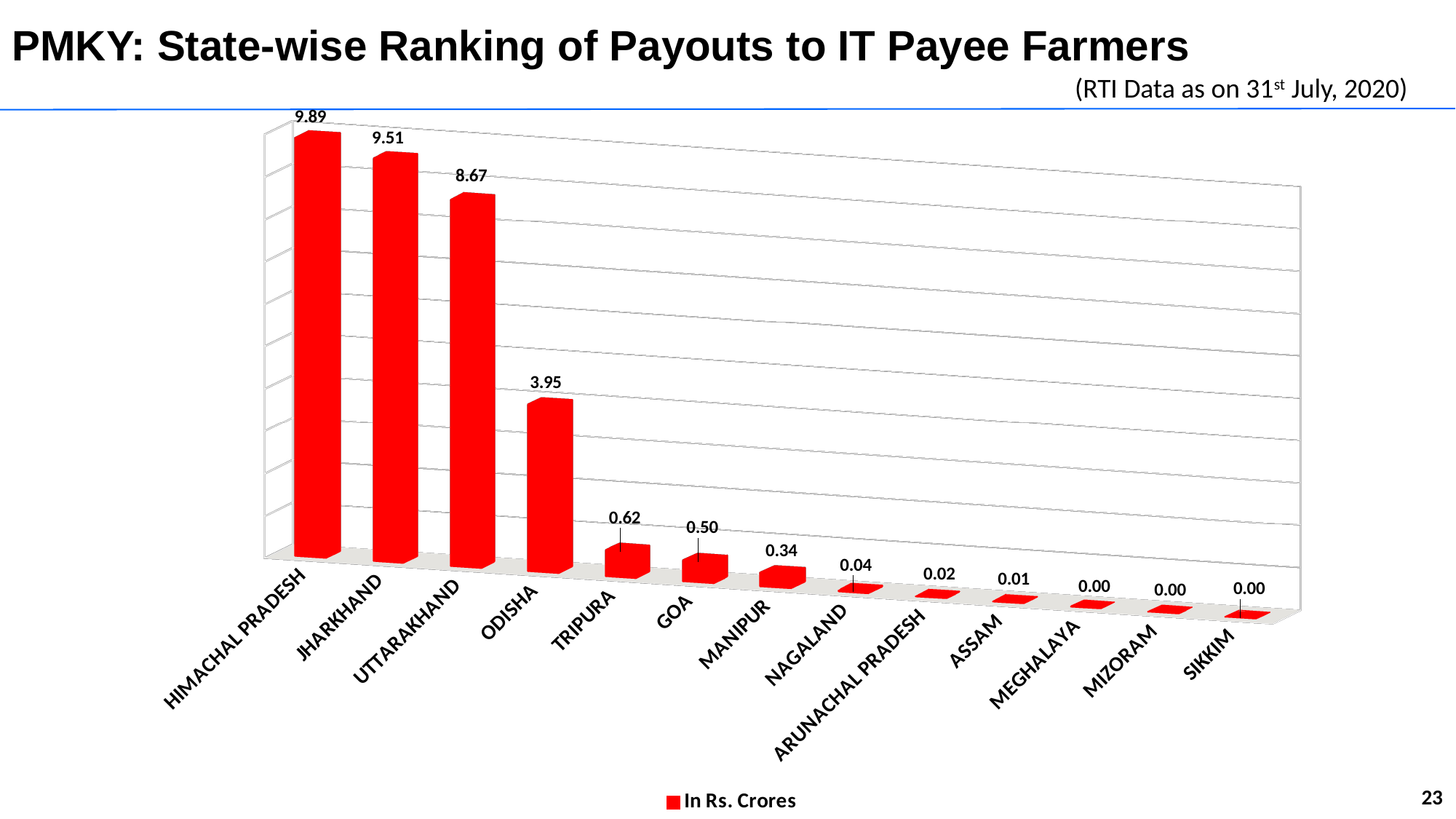
Which is larger, the value for Tripura or the value for Goa? Tripura How many series does the legend list? 1 What is the legend entry for the series? In Rs. Crores What is the value for Odisha? 3.95 What kind of chart is shown? Bar chart Do the values rise or fall from left to right along the x axis? Fall Which state has the highest value? Himachal Pradesh What is the value for Nagaland? 0.04 What is the difference between the values for Jharkhand and Uttarakhand? 0.84 How many states are shown on the chart? 13 What is the value for Himachal Pradesh? 9.89 What is the value for Manipur? 0.34